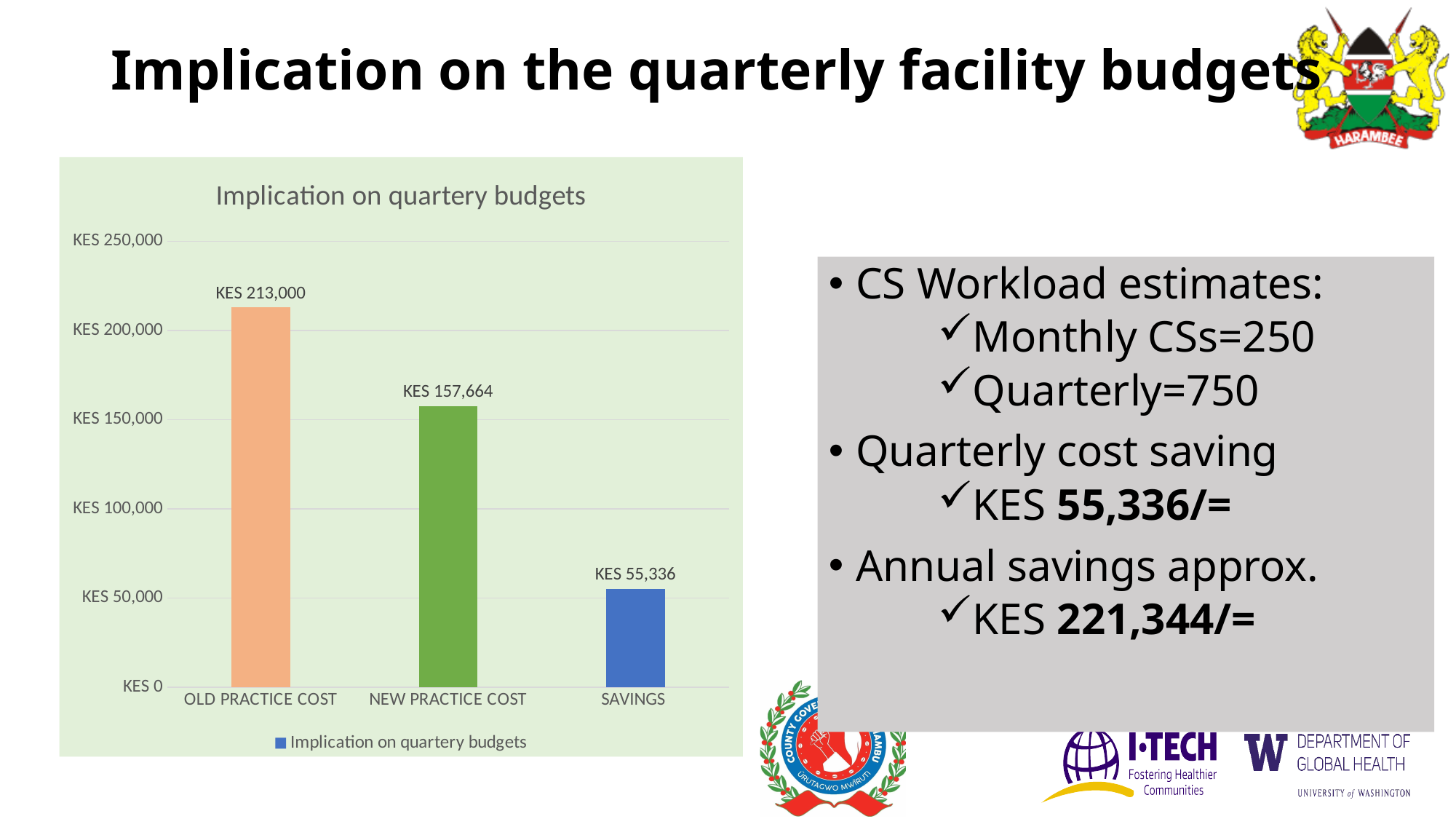
What is the value for NEW PRACTICE COST? KES 157,664 How many series does the legend list? 1 How many categories are shown on the x axis? 3 Which is larger, NEW PRACTICE COST or SAVINGS? NEW PRACTICE COST Which category has the highest value? OLD PRACTICE COST Is the value for NEW PRACTICE COST greater or less than KES 150,000? greater What is the difference between OLD PRACTICE COST and NEW PRACTICE COST? KES 55,336 What is the title of the chart? Implication on quartery budgets Which category has the lowest value? SAVINGS What kind of chart is shown? bar chart What is the value for SAVINGS? KES 55,336 What is the value for OLD PRACTICE COST? KES 213,000